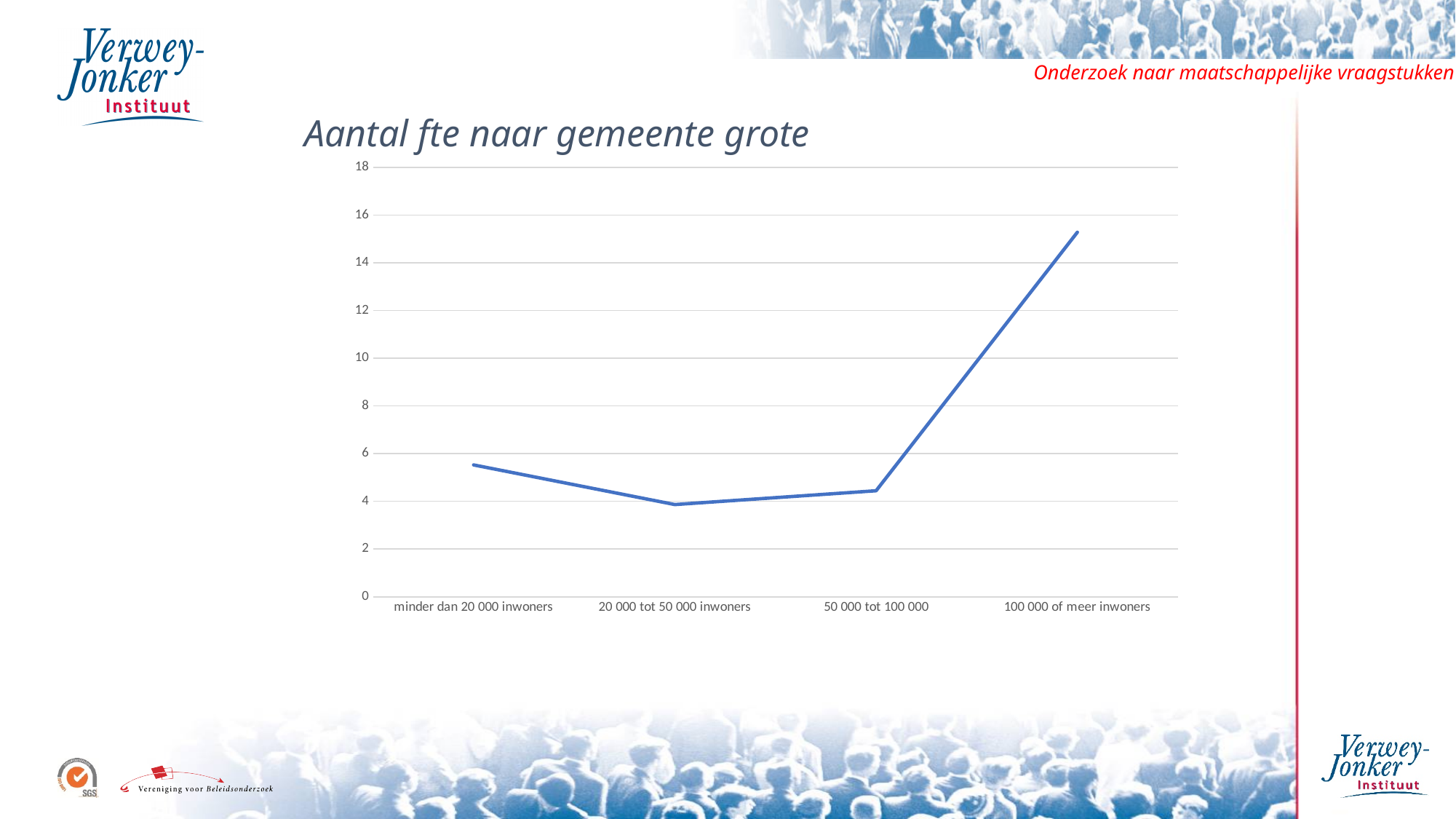
Is the value for 100 000 of meer inwoners greater or less than 14? greater Does the line rise or fall between 50 000 tot 100 000 and 100 000 of meer inwoners? rise What kind of chart is shown on the slide? line chart How many categories are plotted along the x axis? 4 Is the value for 50 000 tot 100 000 greater or less than 6? less Is the value for 20 000 tot 50 000 inwoners greater or less than 6? less What is the highest value shown on the y axis? 18 Which category has the lowest value? 20 000 tot 50 000 inwoners Which category has the highest value? 100 000 of meer inwoners Which is larger, the value for minder dan 20 000 inwoners or the value for 20 000 tot 50 000 inwoners? minder dan 20 000 inwoners What is the title of the chart? Aantal fte naar gemeente grote